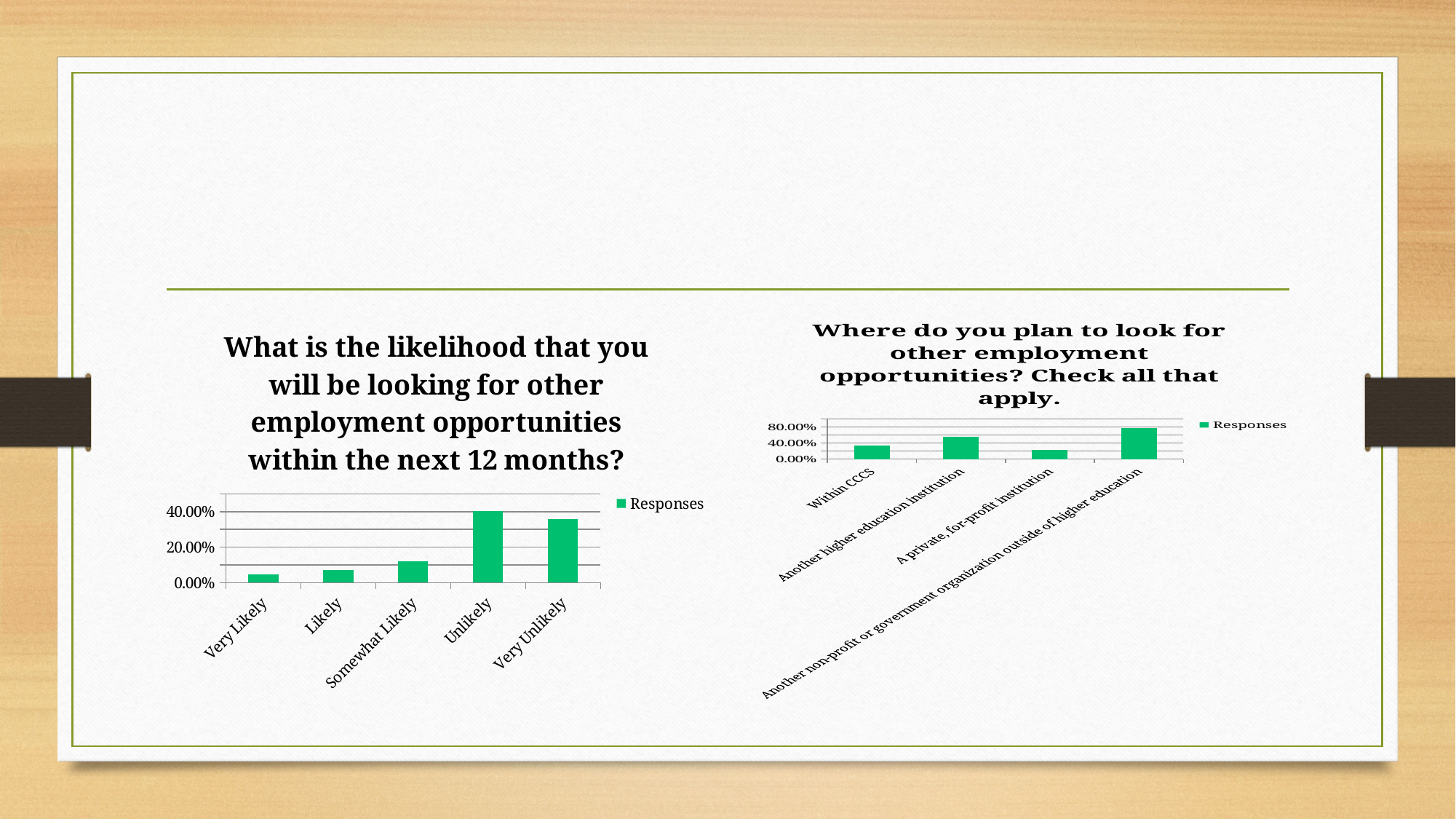
On the right chart about where respondents plan to look for other employment opportunities, is the value for Another higher education institution greater or less than 40.00%? greater How many categories are shown on the left chart about the likelihood of looking for other employment opportunities? 5 On the right chart titled 'Where do you plan to look for other employment opportunities? Check all that apply.', which category has the lowest value? A private, for-profit institution On the left chart about the likelihood of looking for other employment opportunities, which category has the highest value? Unlikely On the left chart about the likelihood of looking for other employment opportunities, which is larger: Likely or Very Unlikely? Very Unlikely How many series does the legend list on the left chart about the likelihood of looking for other employment opportunities? 1 On the left chart about the likelihood of looking for other employment opportunities, which category has the lowest value? Very Likely How many categories are shown on the right chart about where respondents plan to look for other employment opportunities? 4 What kind of chart is the left chart titled 'What is the likelihood that you will be looking for other employment opportunities within the next 12 months?'? bar chart On the right chart titled 'Where do you plan to look for other employment opportunities? Check all that apply.', which category has the highest value? Another non-profit or government organization outside of higher education On the left chart about the likelihood of looking for other employment opportunities, is the value for Somewhat Likely greater or less than 20.00%? less What is the name of the series shown in the legend of the right chart about where respondents plan to look for other employment opportunities? Responses